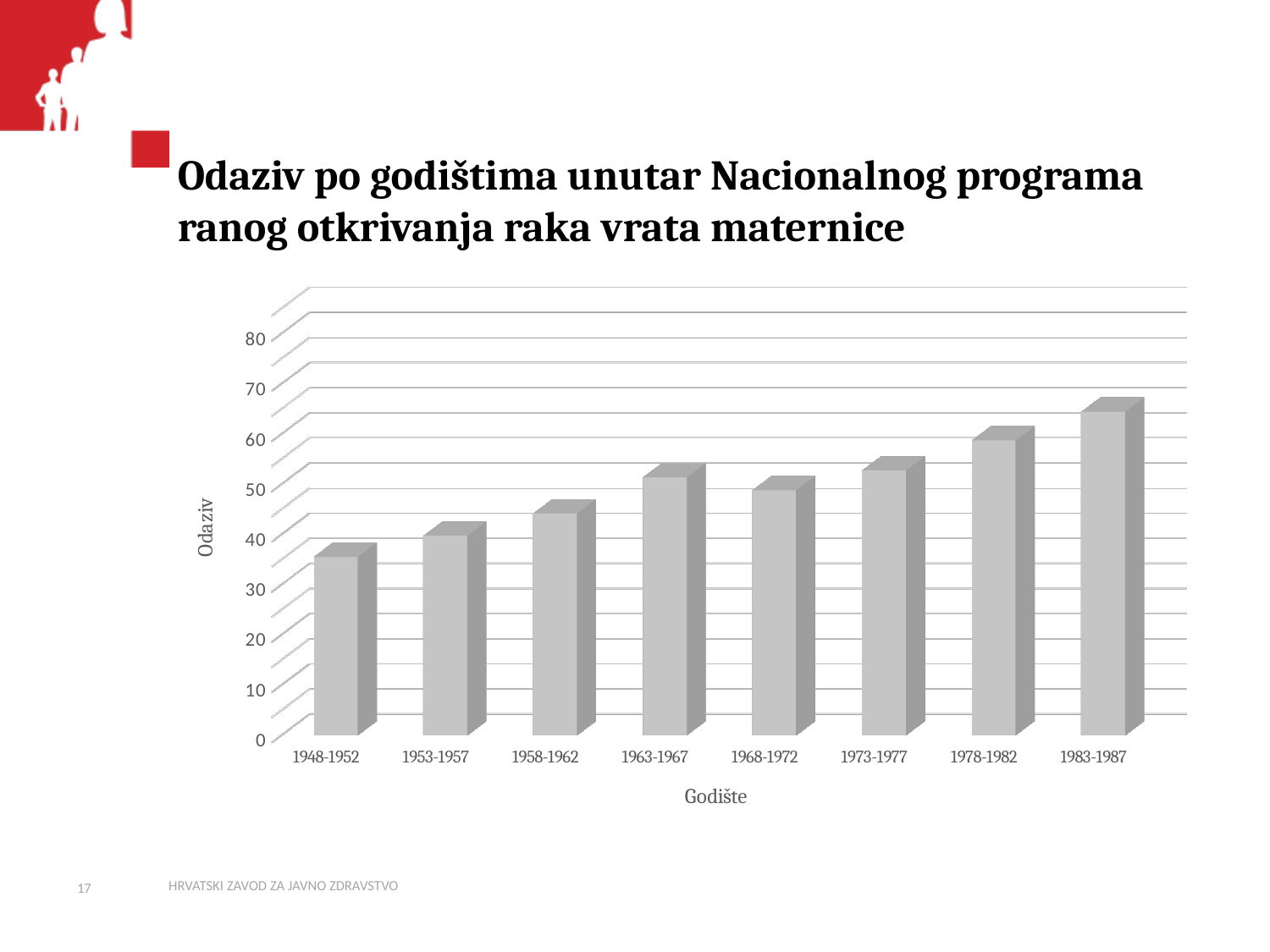
Which godište has the highest odaziv? 1983-1987 How many age-group categories (godišta) are shown on the x axis? 8 Is the value for 1978-1982 greater or less than 50? greater What is the title of the vertical axis? Odaziv Is the value for 1948-1952 greater or less than 40? less What kind of chart is shown on the slide? Bar chart Do the values generally rise or fall from 1948-1952 to 1983-1987? Rise Is the value for 1983-1987 greater or less than 60? greater Which has a higher odaziv, 1973-1977 or 1978-1982? 1978-1982 Which godište has the lowest odaziv? 1948-1952